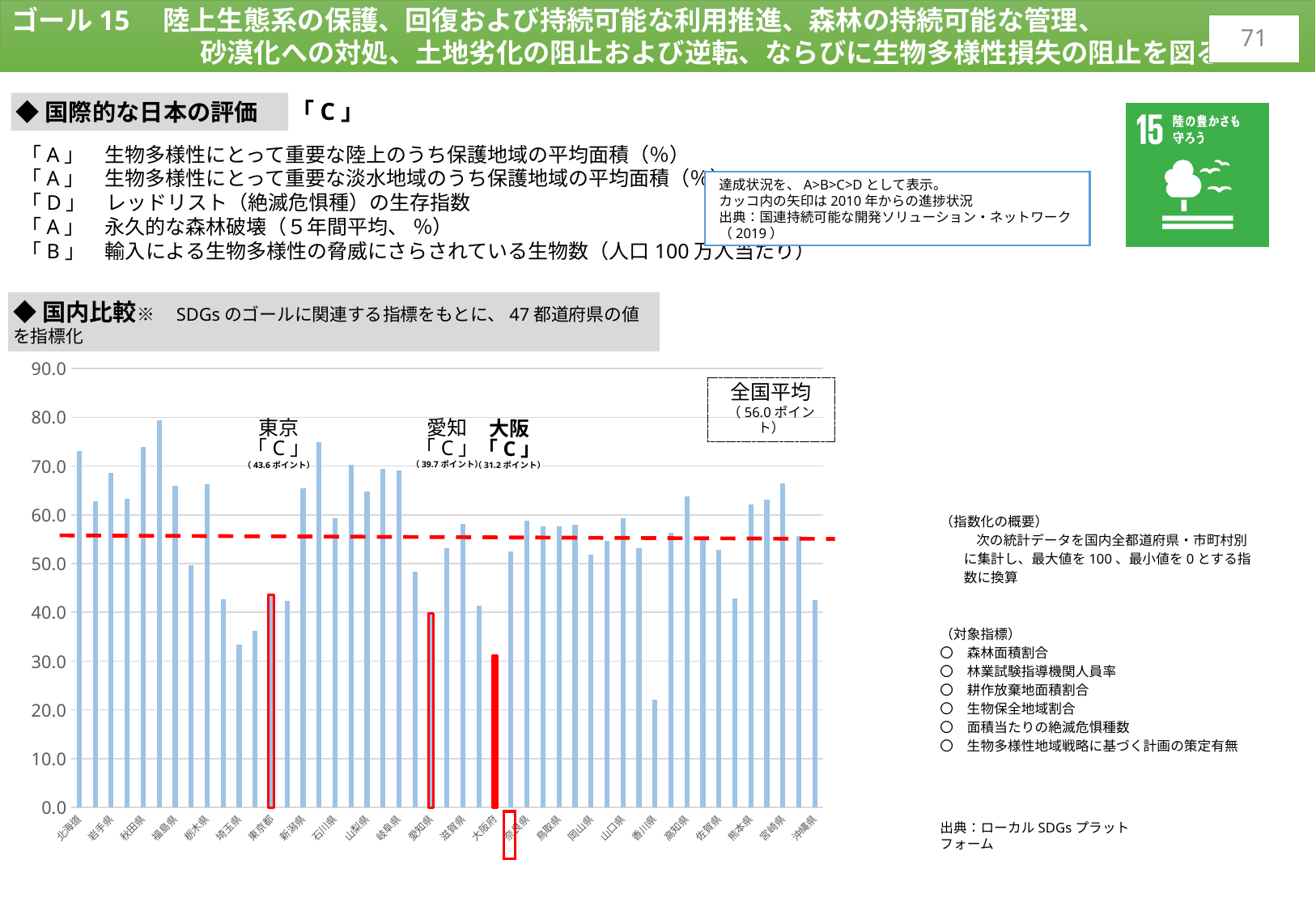
What is the value shown for 愛知 in the 国内比較 bar chart? 39.7 ポイント Which is larger in the 国内比較 chart, the value for 大阪 or the 全国平均? 全国平均 What is the value shown for 大阪 in the 国内比較 bar chart? 31.2 ポイント Which has the larger value in the 国内比較 chart, 東京 or 愛知? 東京 What is the value shown for 東京 in the 国内比較 bar chart? 43.6 ポイント Is the value for 埼玉県 in the 国内比較 chart greater or less than 40? less What is the 全国平均 value shown on the 国内比較 chart? 56.0 ポイント What does the red dashed horizontal line in the 国内比較 chart represent? 全国平均 Is the value for 北海道 in the 国内比較 chart greater or less than 70? greater What is the difference between the 全国平均 and the value for 愛知 in the 国内比較 chart? 16.3 ポイント What is the difference between the values for 東京 and 大阪 in the 国内比較 chart? 12.4 ポイント What kind of chart is used for the 国内比較 section? bar chart